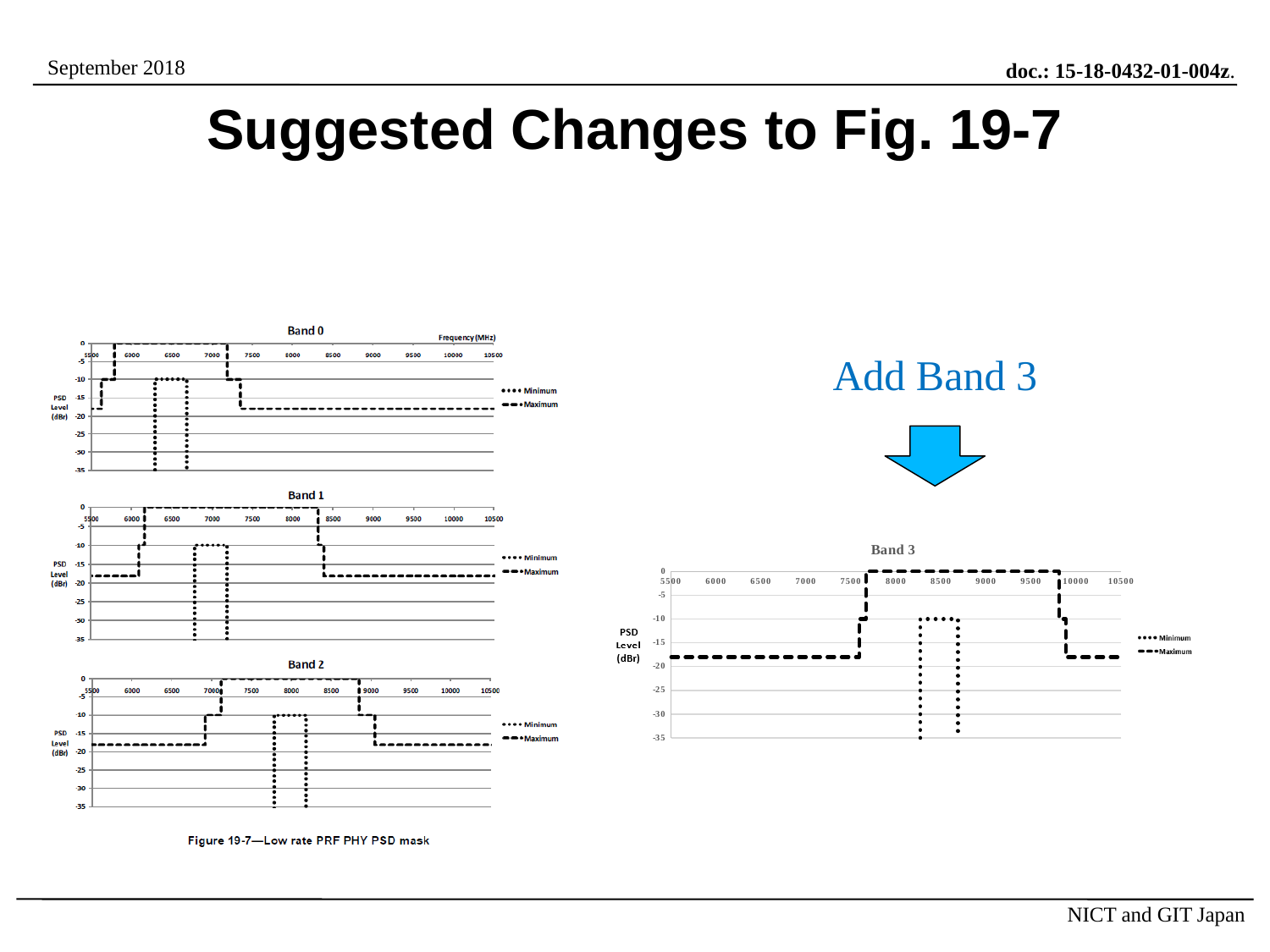
What are the two legend entries in the Band 3 chart? Minimum and Maximum In the Band 0 chart, is the Maximum line at 9000 MHz greater or less than -15? less What kind of chart is the Band 3 chart on the right of the slide? line chart In the Band 3 chart, what is the highest PSD level reached by the Minimum line? -10 In the Band 3 chart, what is the lowest PSD level the Minimum line drops to? -35 In the Band 3 chart, is the Maximum line at 9000 MHz greater or less than -5? greater In the Band 3 chart, which line is higher at 8500 MHz, Minimum or Maximum? Maximum In the Band 3 chart, is the Maximum line at 6000 MHz greater or less than -15? less How many band charts are shown on the slide in total? 4 In the Band 3 chart, what is the highest PSD level reached by the Maximum line? 0 How many series does the legend of the Band 3 chart list? 2 What is the y-axis label of the Band 3 chart? PSD Level (dBr)